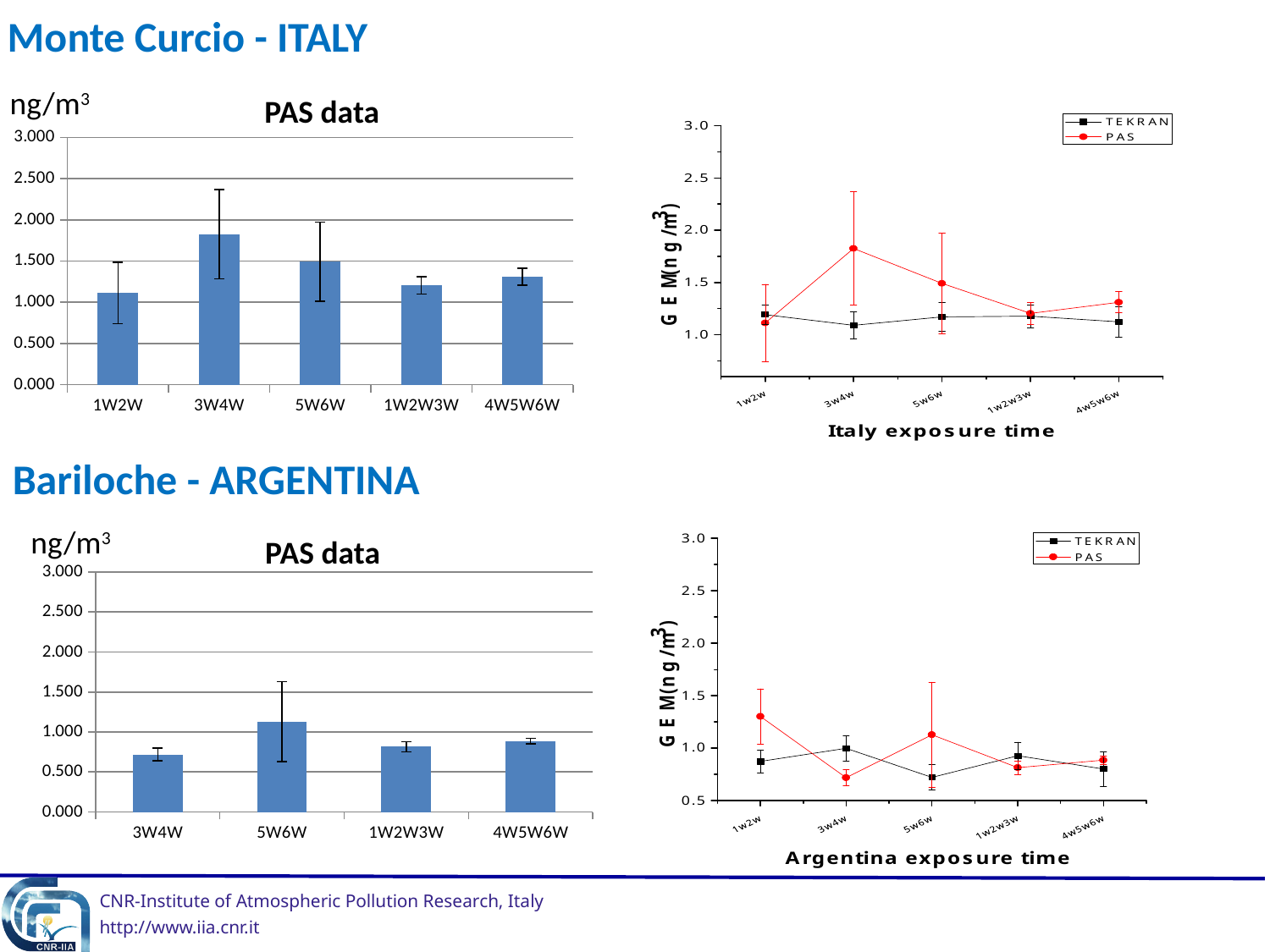
How many series does the legend list in the top-right line chart (Italy exposure time)? 2 In the top-left 'PAS data' bar chart (Monte Curcio - ITALY), how many categories are shown on the x axis? 5 In the top-left 'PAS data' bar chart (Monte Curcio - ITALY), which is larger, the value for 3W4W or the value for 5W6W? 3W4W What kind of chart is the top-left 'PAS data' chart for Monte Curcio - ITALY? bar chart In the bottom-left 'PAS data' bar chart (Bariloche - ARGENTINA), which category has the lowest value? 3W4W In the bottom-left 'PAS data' bar chart (Bariloche - ARGENTINA), how many categories are shown on the x axis? 4 In the bottom-left 'PAS data' bar chart (Bariloche - ARGENTINA), which category has the highest value? 5W6W In the top-left 'PAS data' bar chart (Monte Curcio - ITALY), which category has the highest value? 3W4W In the top-left 'PAS data' bar chart (Monte Curcio - ITALY), is the value for 3W4W greater or less than 1.500? greater In the bottom-left 'PAS data' bar chart (Bariloche - ARGENTINA), is the value for 5W6W greater or less than 1.000? greater What kind of chart is the bottom-right chart with the x-axis title 'Argentina exposure time'? line chart What are the two legend entries in the bottom-right chart (Argentina exposure time)? TEKRAN and PAS